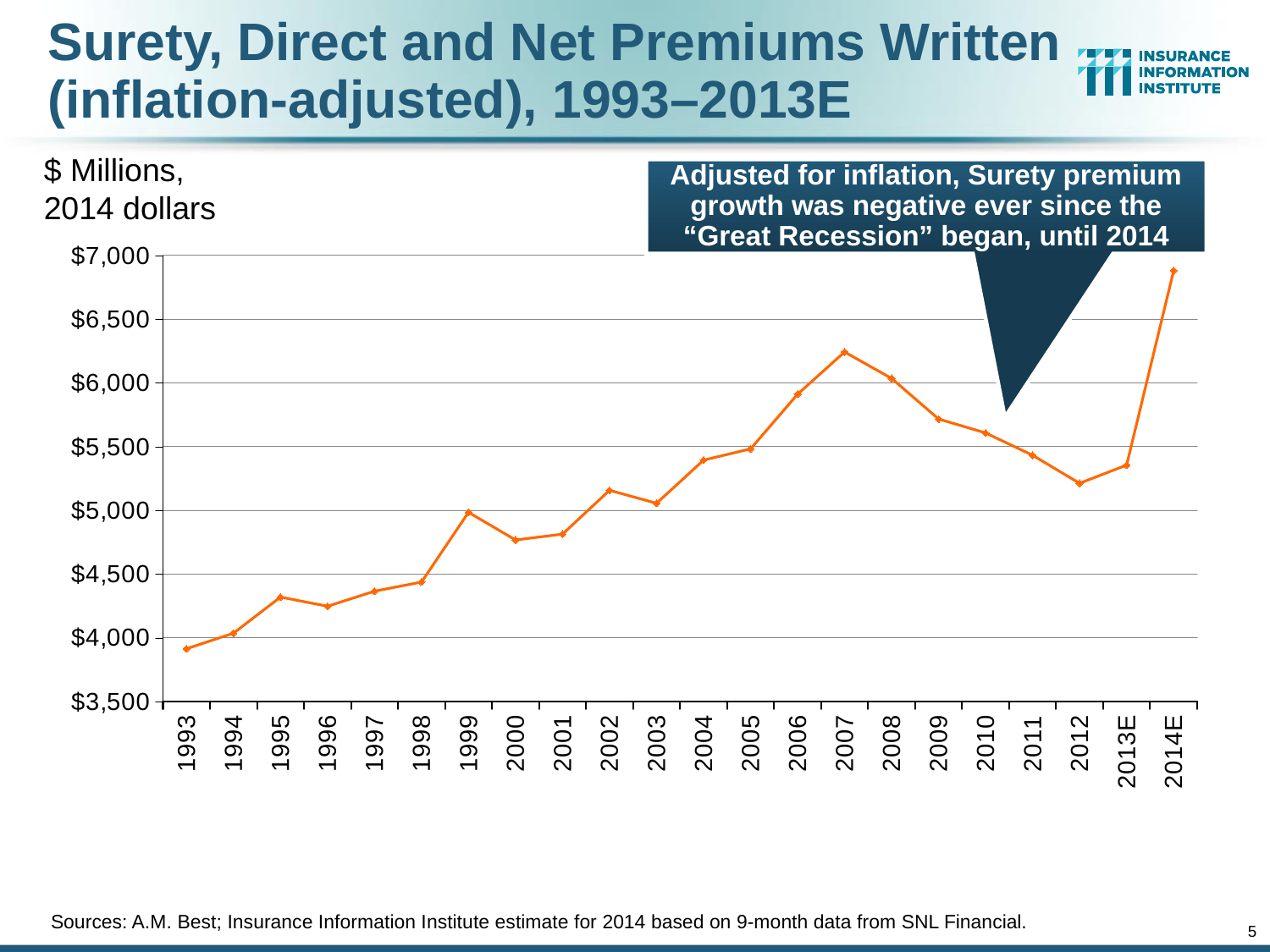
Is the value for 2007 greater or less than $6,000? greater Which year has the larger value, 2011 or 2012? 2011 Which year has the highest value on the chart? 2014E Which year has the larger value, 2007 or 2008? 2007 What unit is stated for the values on the chart? $ Millions, 2014 dollars Do the values rise or fall from 2007 to 2012? fall What kind of chart is shown on the slide? Line chart Is the value for 2014E greater or less than $6,500? greater Is the value for 2012 greater or less than $5,500? less Which year has the lowest value on the chart? 1993 How many years are plotted along the x axis of the chart? 22